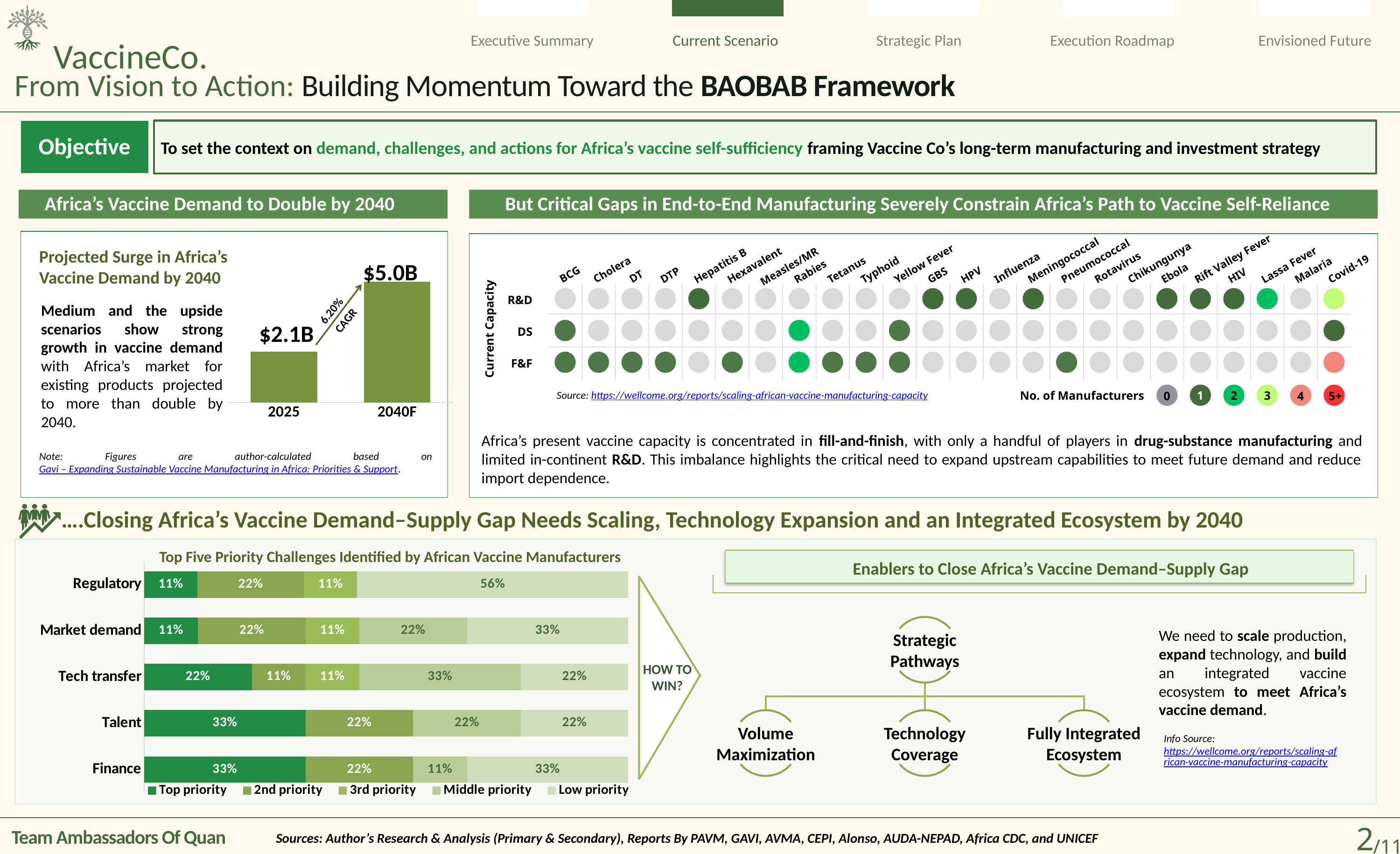
In the 'Top Five Priority Challenges Identified by African Vaccine Manufacturers' chart, what is the difference between the Top priority share for Finance and for Market demand? 22 percentage points In the 'Top Five Priority Challenges Identified by African Vaccine Manufacturers' chart, what kind of chart is it? Stacked bar chart In the 'Top Five Priority Challenges Identified by African Vaccine Manufacturers' chart, how many series does the legend list? 5 In the 'Top Five Priority Challenges Identified by African Vaccine Manufacturers' chart, what is the Top priority share for Tech transfer? 22% In the 'Top Five Priority Challenges Identified by African Vaccine Manufacturers' chart, which has the larger Top priority share: Tech transfer or Regulatory? Tech transfer In the 'Projected Surge in Africa's Vaccine Demand by 2040' chart, how many bars are plotted? 2 In the 'Top Five Priority Challenges Identified by African Vaccine Manufacturers' chart, how many challenge categories are shown? 5 In the 'Projected Surge in Africa's Vaccine Demand by 2040' chart, what is the value for 2025? $2.1B In the 'Top Five Priority Challenges Identified by African Vaccine Manufacturers' chart, what is the Top priority share for Talent? 33% In the 'Projected Surge in Africa's Vaccine Demand by 2040' chart, what is the difference between the 2040F and 2025 values? $2.9B In the 'Projected Surge in Africa's Vaccine Demand by 2040' chart, what is the value for 2040F? $5.0B In the 'Projected Surge in Africa's Vaccine Demand by 2040' chart, what CAGR is shown on the arrow between the bars? 6.20%